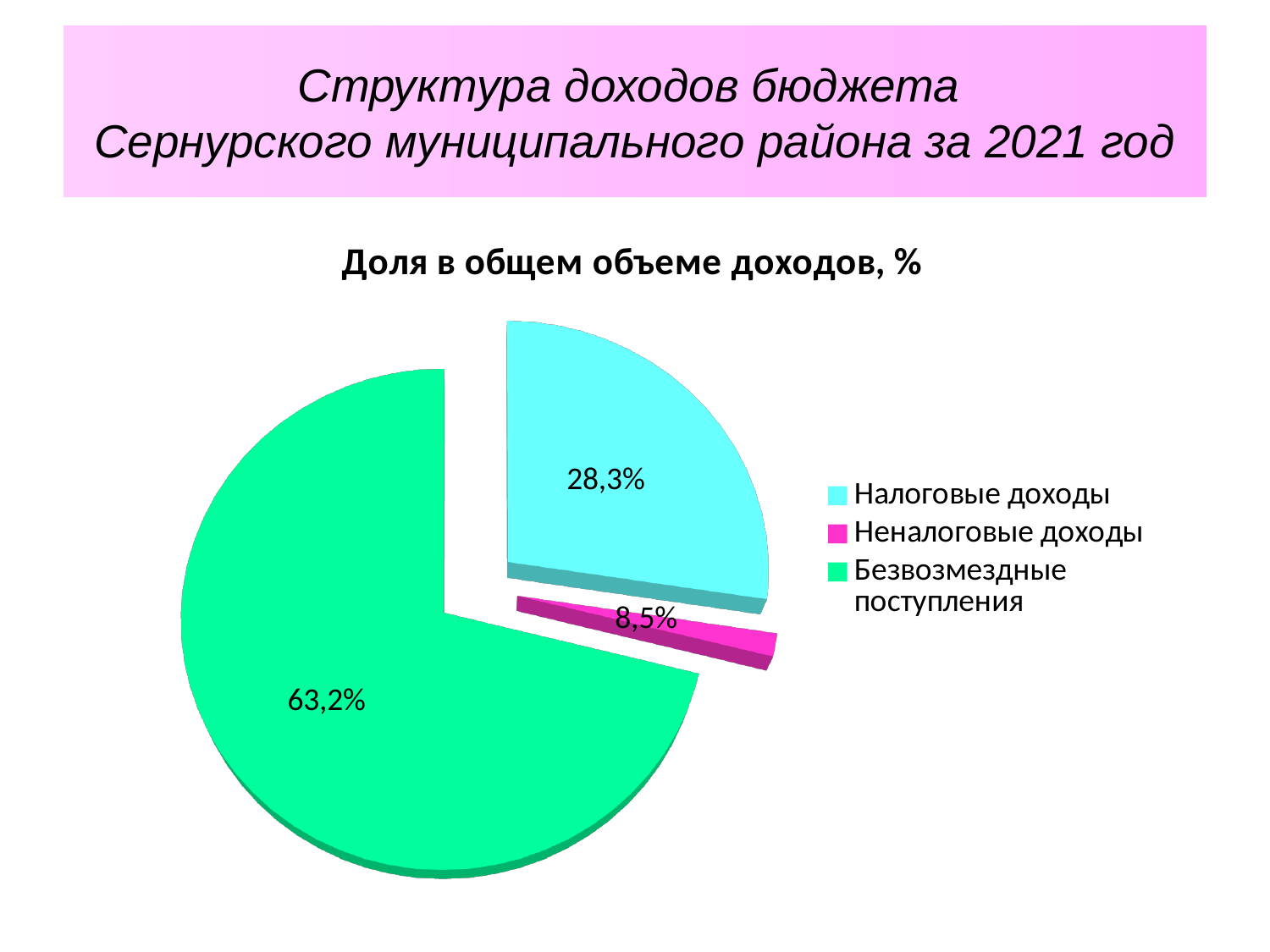
How many categories does the pie chart show? 3 Which is larger: the share of Налоговые доходы or the share of Неналоговые доходы? Налоговые доходы Which category has the smallest share of the pie? Неналоговые доходы What is the share of Безвозмездные поступления in the pie chart? 63,2% What kind of chart is shown on the slide? pie chart What is the share of Налоговые доходы in the pie chart? 28,3% How many entries does the legend list? 3 What is the difference in percentage points between Безвозмездные поступления and Налоговые доходы? 34,9 What colour is the slice for Неналоговые доходы? pink (magenta) What is the share of Неналоговые доходы in the pie chart? 8,5% What is the title of the chart? Доля в общем объеме доходов, % Which category has the largest share of the pie? Безвозмездные поступления